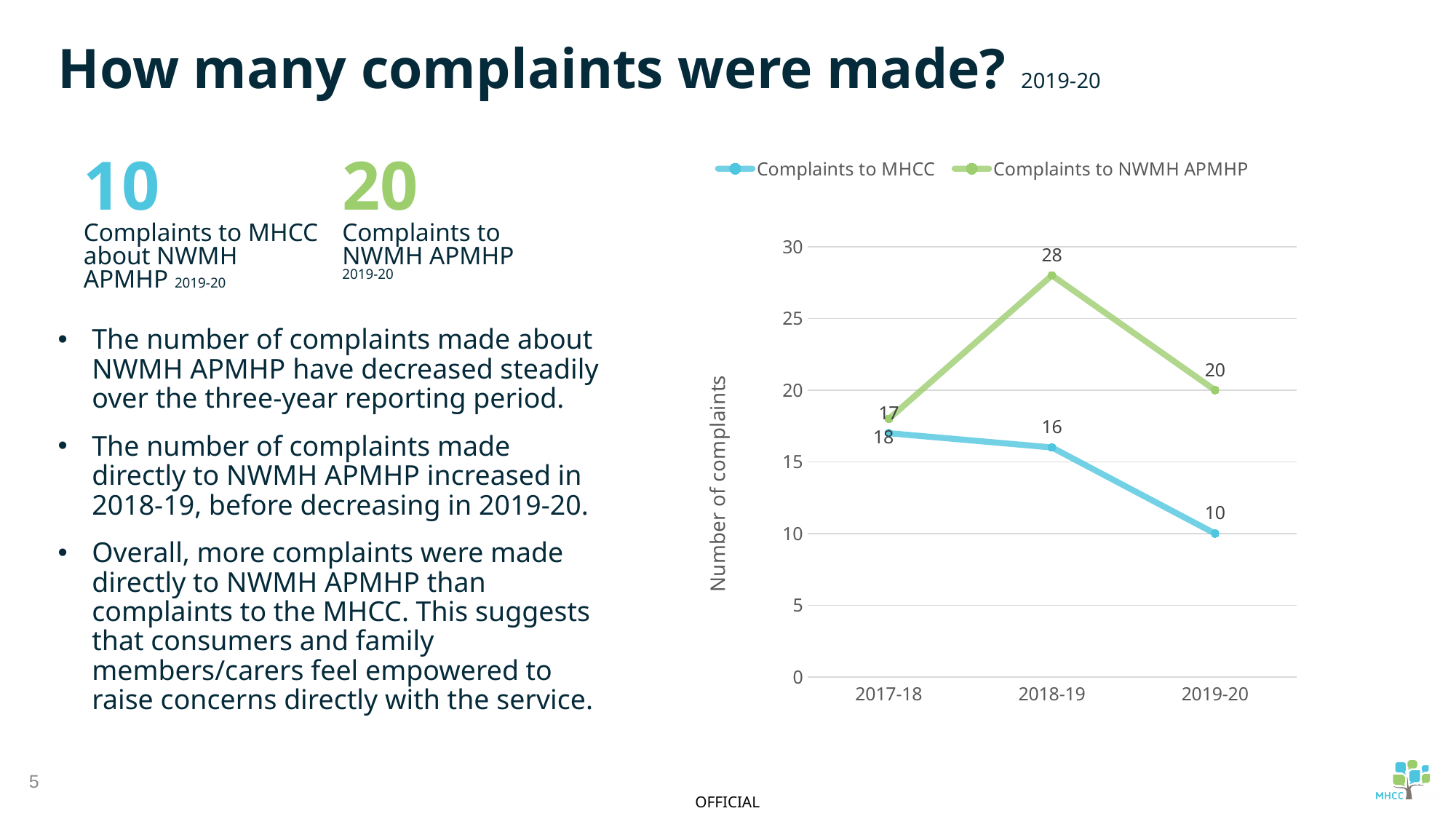
In which year were Complaints to NWMH APMHP highest? 2018-19 How many years are shown on the x axis of the chart? 3 In 2018-19, which series has the higher value, Complaints to MHCC or Complaints to NWMH APMHP? Complaints to NWMH APMHP By how much did Complaints to NWMH APMHP fall from 2018-19 to 2019-20? 8 What is the value for Complaints to NWMH APMHP in 2018-19? 28 In 2019-20, what is the difference between Complaints to NWMH APMHP and Complaints to MHCC? 10 What is the value for Complaints to MHCC in 2019-20? 10 In which year were Complaints to MHCC lowest? 2019-20 What is the value for Complaints to NWMH APMHP in 2019-20? 20 How many series does the chart legend list? 2 What is the value for Complaints to MHCC in 2018-19? 16 What kind of chart is shown on the slide? Line chart